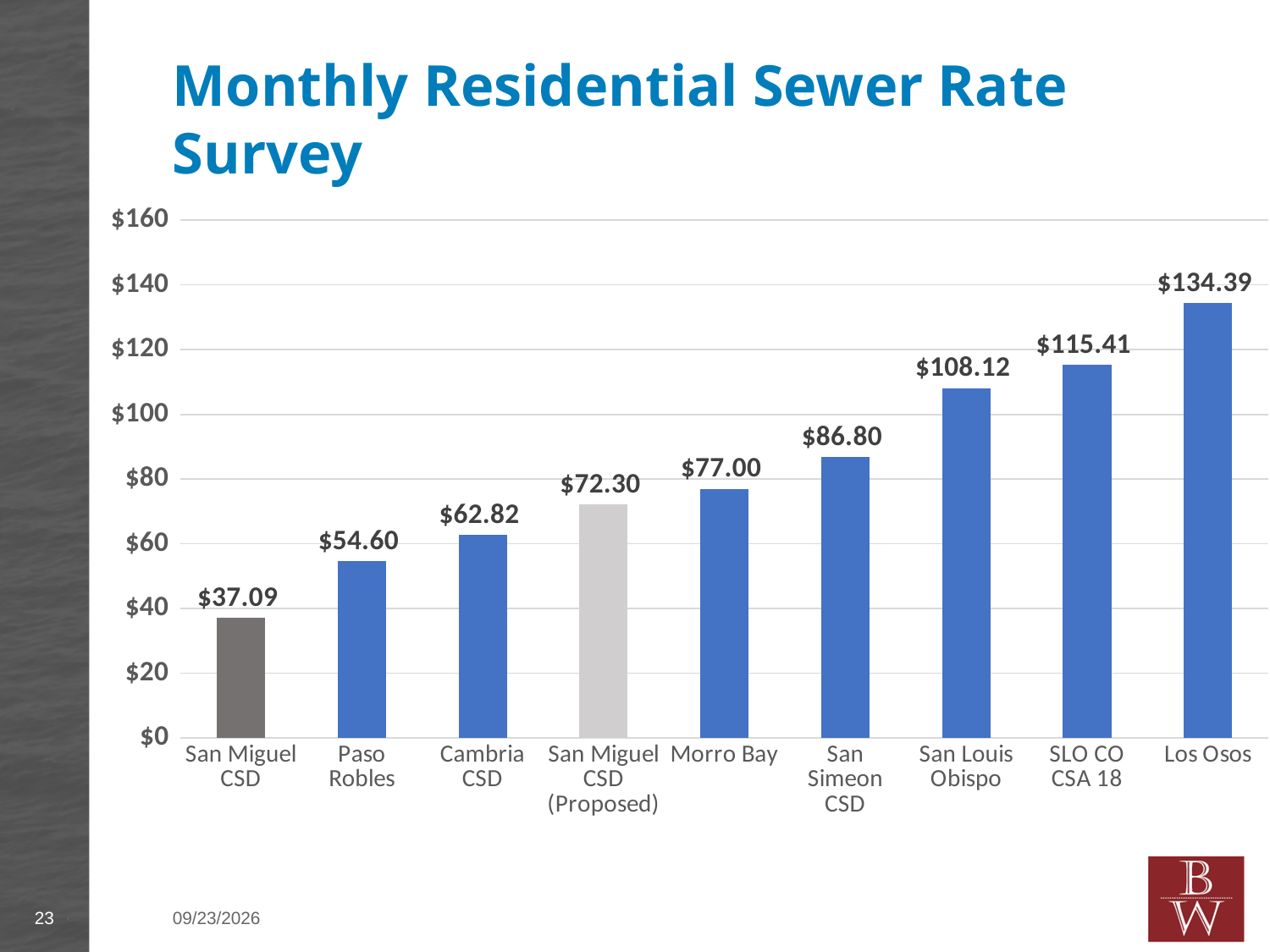
What is the monthly residential sewer rate for Morro Bay? $77.00 How much higher is the Los Osos rate than the San Louis Obispo rate? $26.27 What type of chart is shown on the slide? Bar chart What is the proposed monthly sewer rate for San Miguel CSD? $72.30 Is the value for Paso Robles greater or less than $60? less Which agency has the lowest monthly residential sewer rate? San Miguel CSD How many agencies are shown in the chart? 9 Which has a higher monthly sewer rate, Cambria CSD or San Simeon CSD? San Simeon CSD What is the difference between the proposed San Miguel CSD rate and the current San Miguel CSD rate? $35.21 What is the monthly sewer rate shown for SLO CO CSA 18? $115.41 Which agency has the highest monthly residential sewer rate? Los Osos Do the sewer rates rise or fall from left to right across the chart? Rise